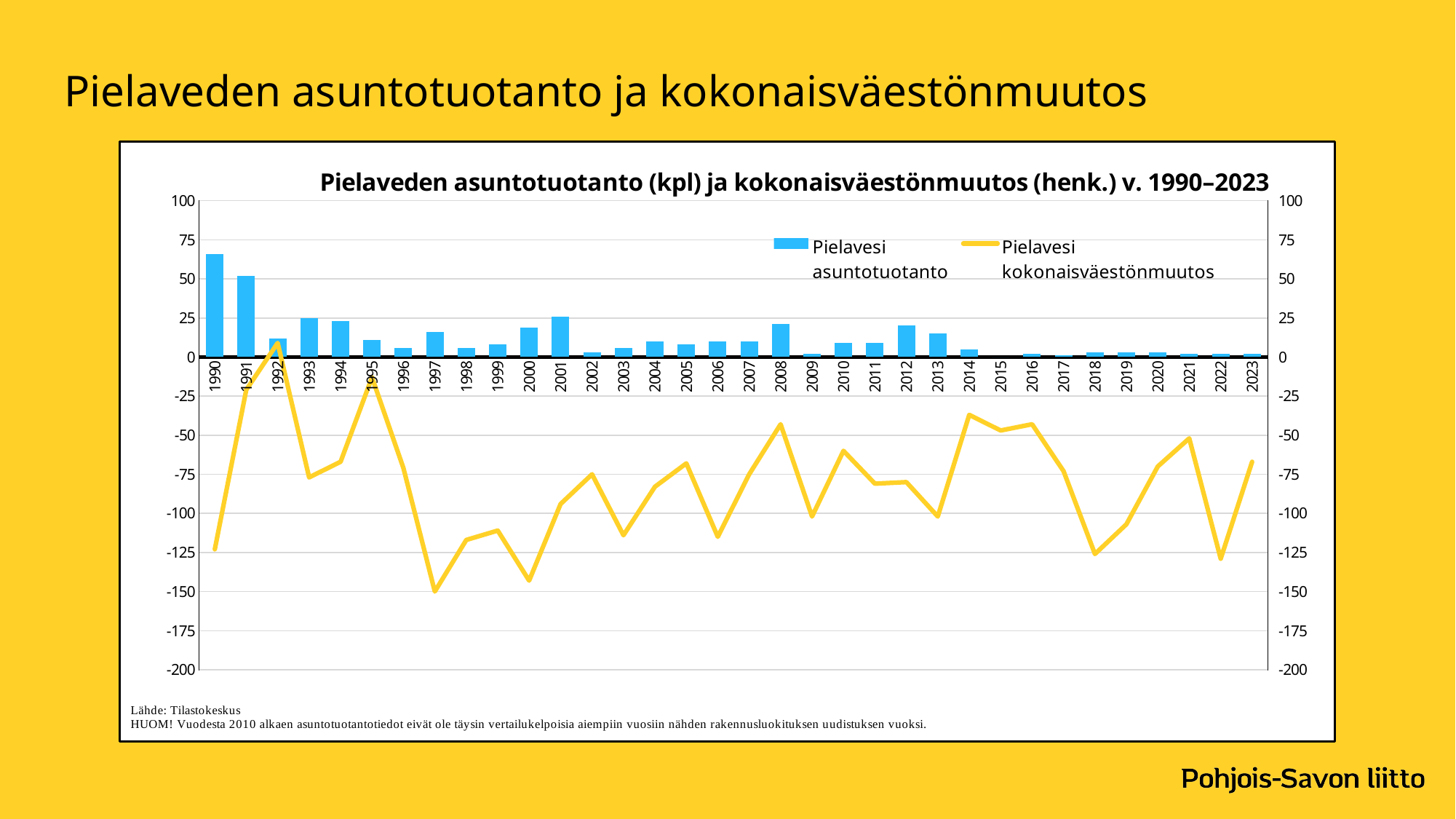
Which year has the larger Pielavesi asuntotuotanto bar, 1990 or 1991? 1990 What kind of chart is shown on the slide? A combined bar and line chart Is the Pielavesi kokonaisväestönmuutos value for 2014 greater or less than -50? greater How many years are shown on the x axis of the chart? 34 Is the Pielavesi kokonaisväestönmuutos value for 1997 greater or less than -125? less Is the Pielavesi asuntotuotanto value for 1990 greater or less than 50? greater In which year is the Pielavesi asuntotuotanto bar the highest? 1990 How many series does the chart legend list? 2 Do the Pielavesi asuntotuotanto bars generally rise or fall from 1990 to 2023? fall In which year does the Pielavesi kokonaisväestönmuutos line reach its lowest point? 1997 What colour is the Pielavesi kokonaisväestönmuutos line in the chart? Yellow